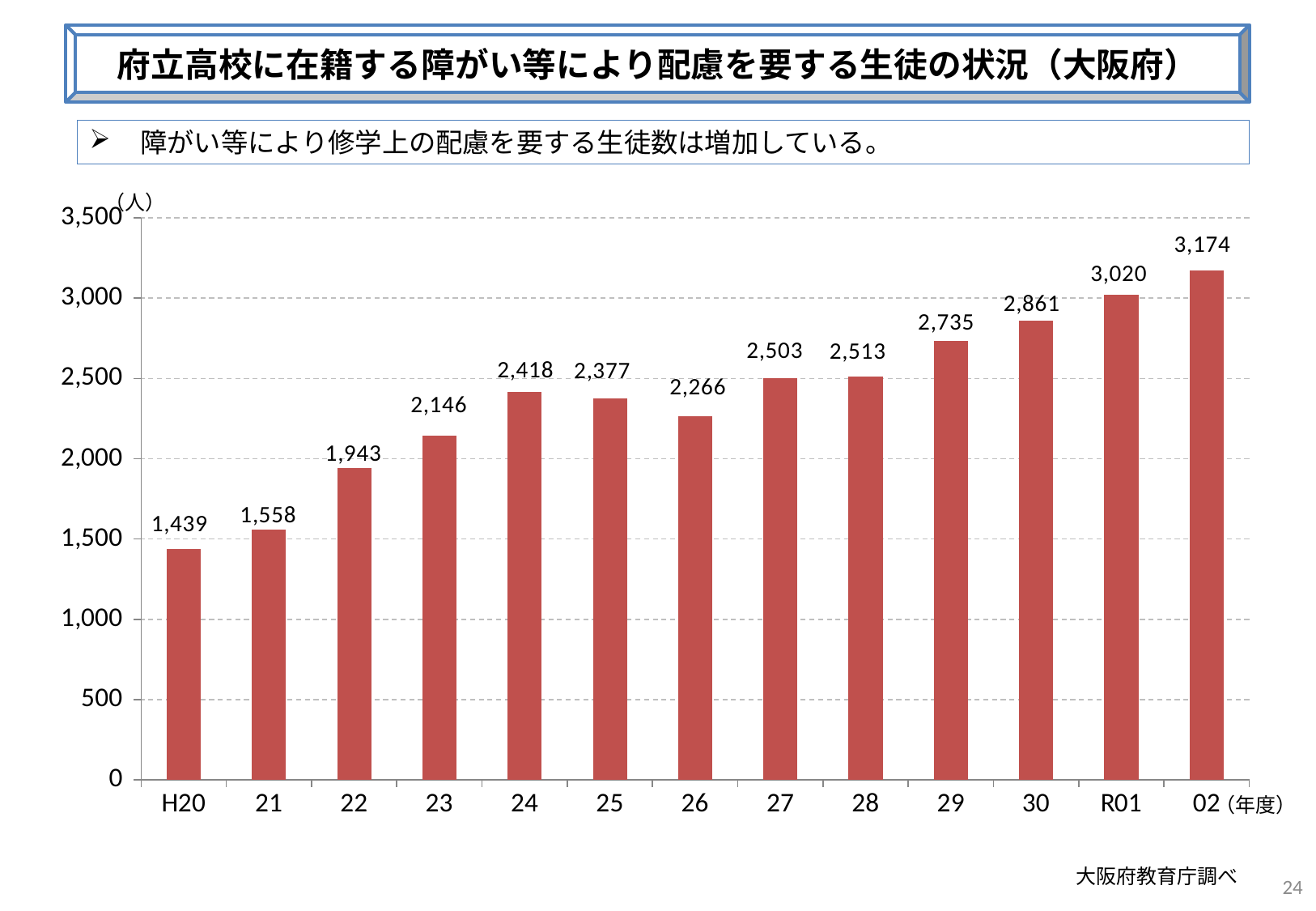
Which is larger, the value for 25 or the value for 26? 25 What is the value for H20? 1,439 Do the values generally rise or fall from H20 to 02? rise How many years are shown on the x axis? 13 What kind of chart is this? bar chart What is the value for 26? 2,266 Which year has the lowest value? H20 What is the value for R01? 3,020 Which year has the highest value? 02 Is the value for 30 greater or less than 3,000? less What is the difference between the values for 02 and H20? 1,735 What is the difference between the values for 24 and 25? 41